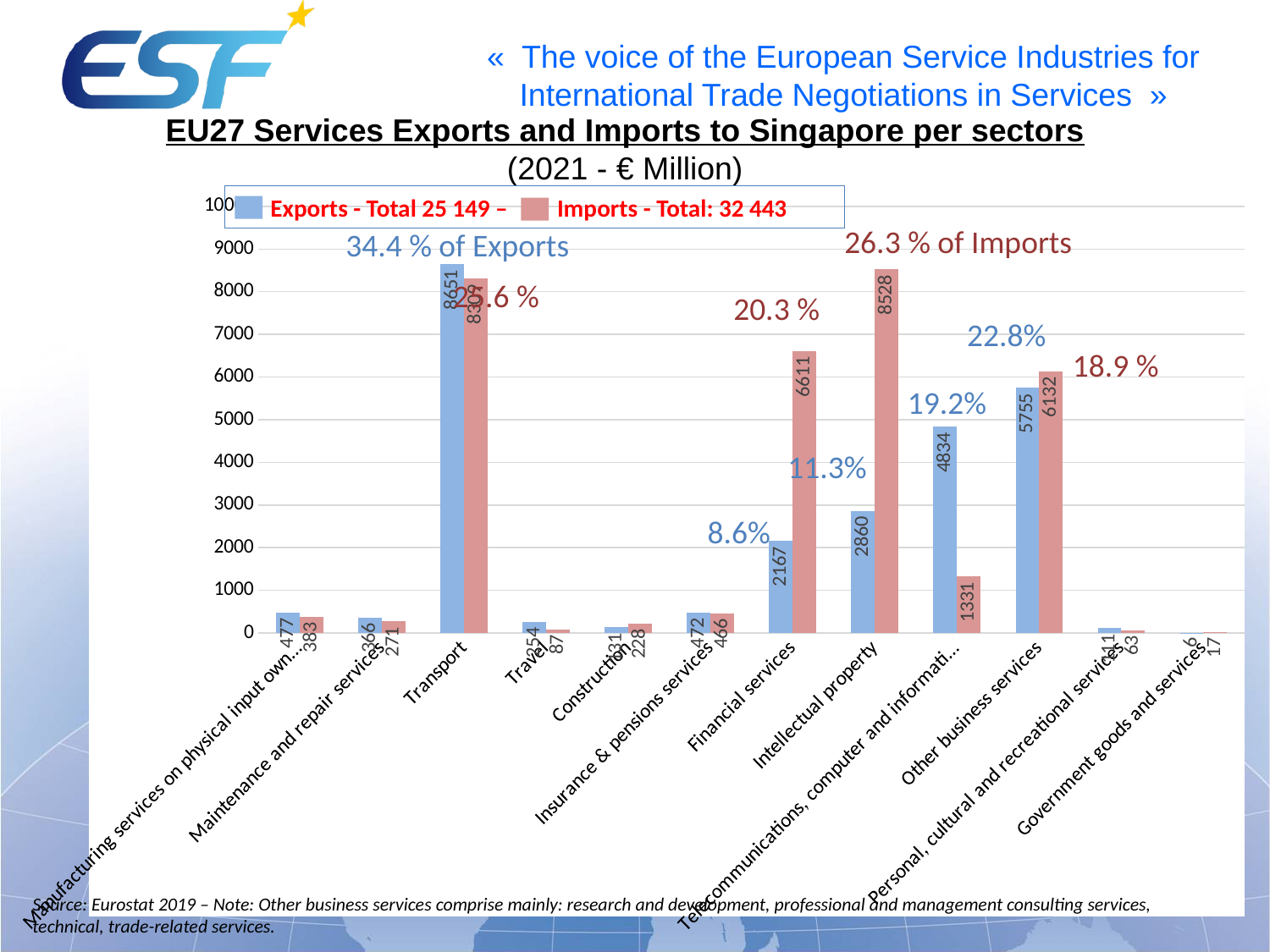
Which sector has the highest Imports value? Intellectual property What is the value of Exports for Financial services? 2167 What is the difference between Imports and Exports for Financial services? 4444 For Telecommunications, computer and information services, which is larger: Exports or Imports? Exports What kind of chart is shown on the slide? Bar chart How many sectors are shown on the x axis? 12 What is the value of Exports for Telecommunications, computer and information services? 4834 How many series does the legend list? 2 Which sector has the highest Exports value? Transport What is the value of Imports for Intellectual property? 8528 Which sector has the lowest Exports value? Government goods and services What is the value of Imports for Other business services? 6132